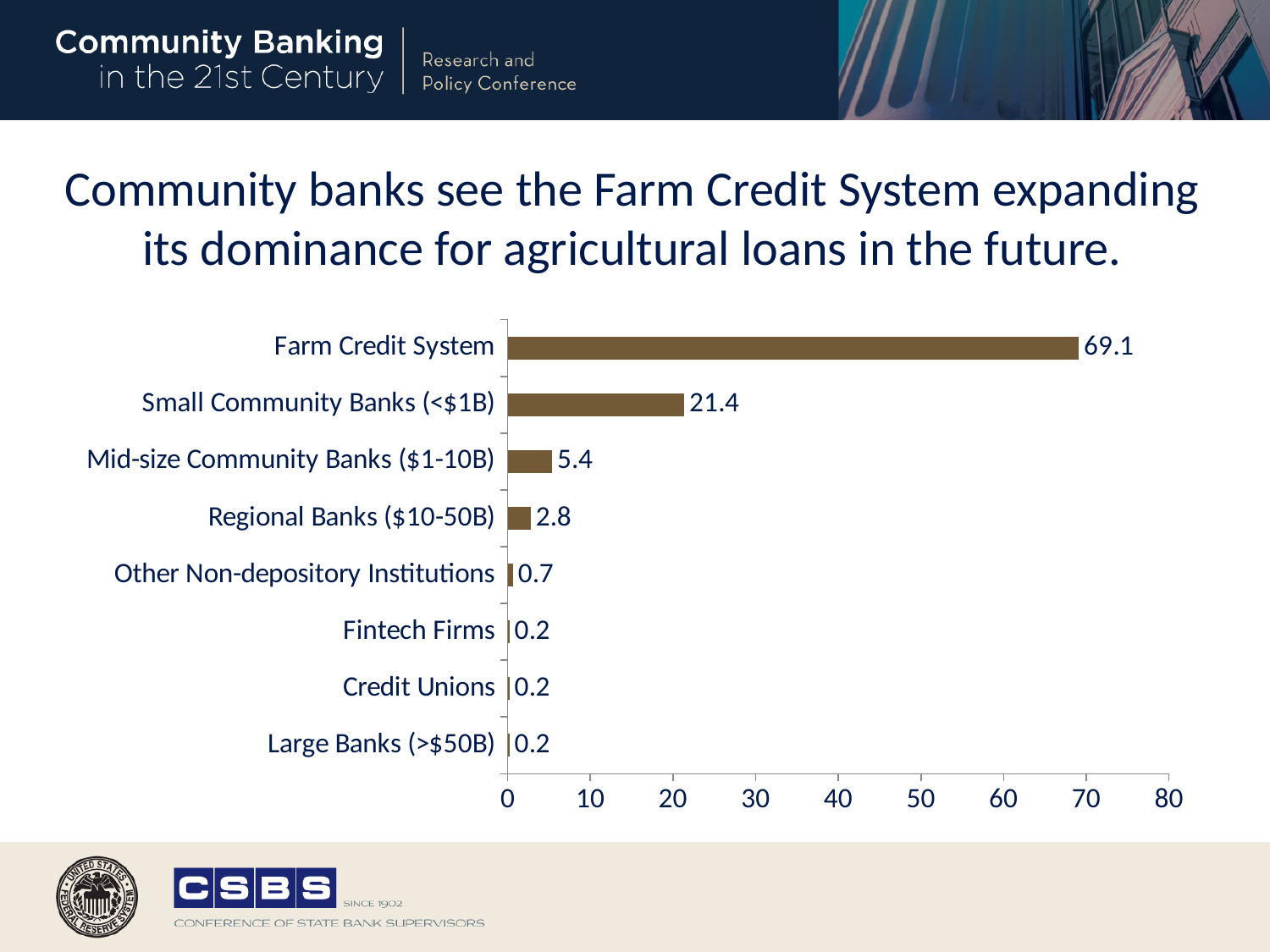
What is the difference between the values for Farm Credit System and Small Community Banks (<$1B)? 47.7 What is the value for Mid-size Community Banks ($1-10B)? 5.4 What is the value for Farm Credit System? 69.1 What is the value for Other Non-depository Institutions? 0.7 Which category has the highest value? Farm Credit System What is the value for Regional Banks ($10-50B)? 2.8 Is the value for Small Community Banks (<$1B) greater or less than 20? greater What is the value for Small Community Banks (<$1B)? 21.4 How many categories are shown in the chart? 8 What is the maximum value shown on the horizontal axis? 80 Which is larger, the value for Mid-size Community Banks ($1-10B) or Regional Banks ($10-50B)? Mid-size Community Banks ($1-10B) What kind of chart is shown on the slide? Bar chart